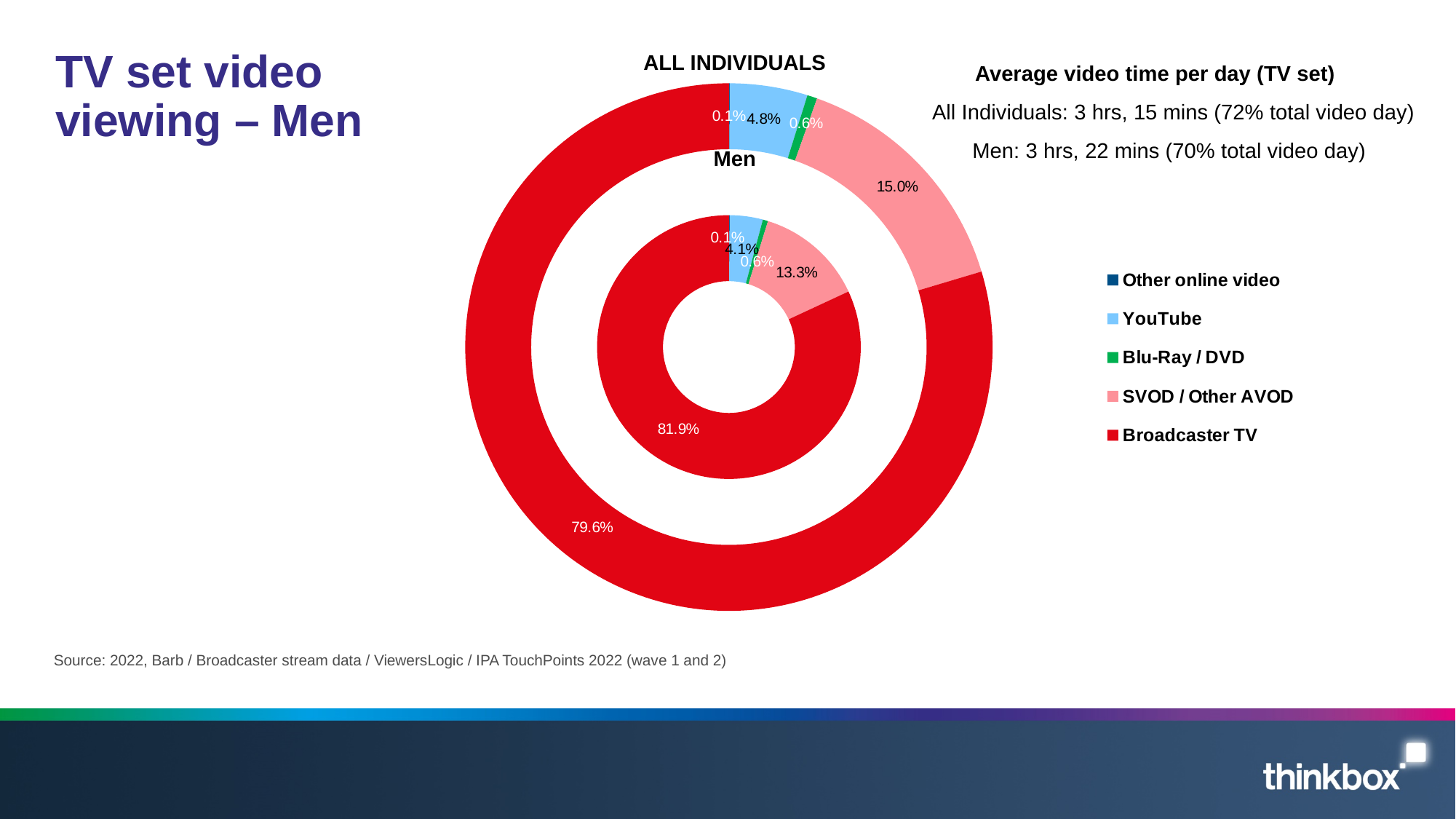
What is the difference between the SVOD / Other AVOD share for All Individuals and for Men? 1.7 percentage points What share of TV set video viewing is Broadcaster TV for Men (inner ring)? 81.9% What is the Blu-Ray / DVD share for Men? 0.6% Is the YouTube share larger for All Individuals or for Men? All Individuals Which category has the largest share in the Men ring? Broadcaster TV Which colour represents Broadcaster TV in the chart? Red Which category has the smallest share in the All Individuals ring? Other online video What kind of chart is shown on the slide? Doughnut chart How many categories does the legend list? 5 What is the YouTube share for All Individuals? 4.8% What is the SVOD / Other AVOD share for Men? 13.3% What share of TV set video viewing is Broadcaster TV for All Individuals (outer ring)? 79.6%